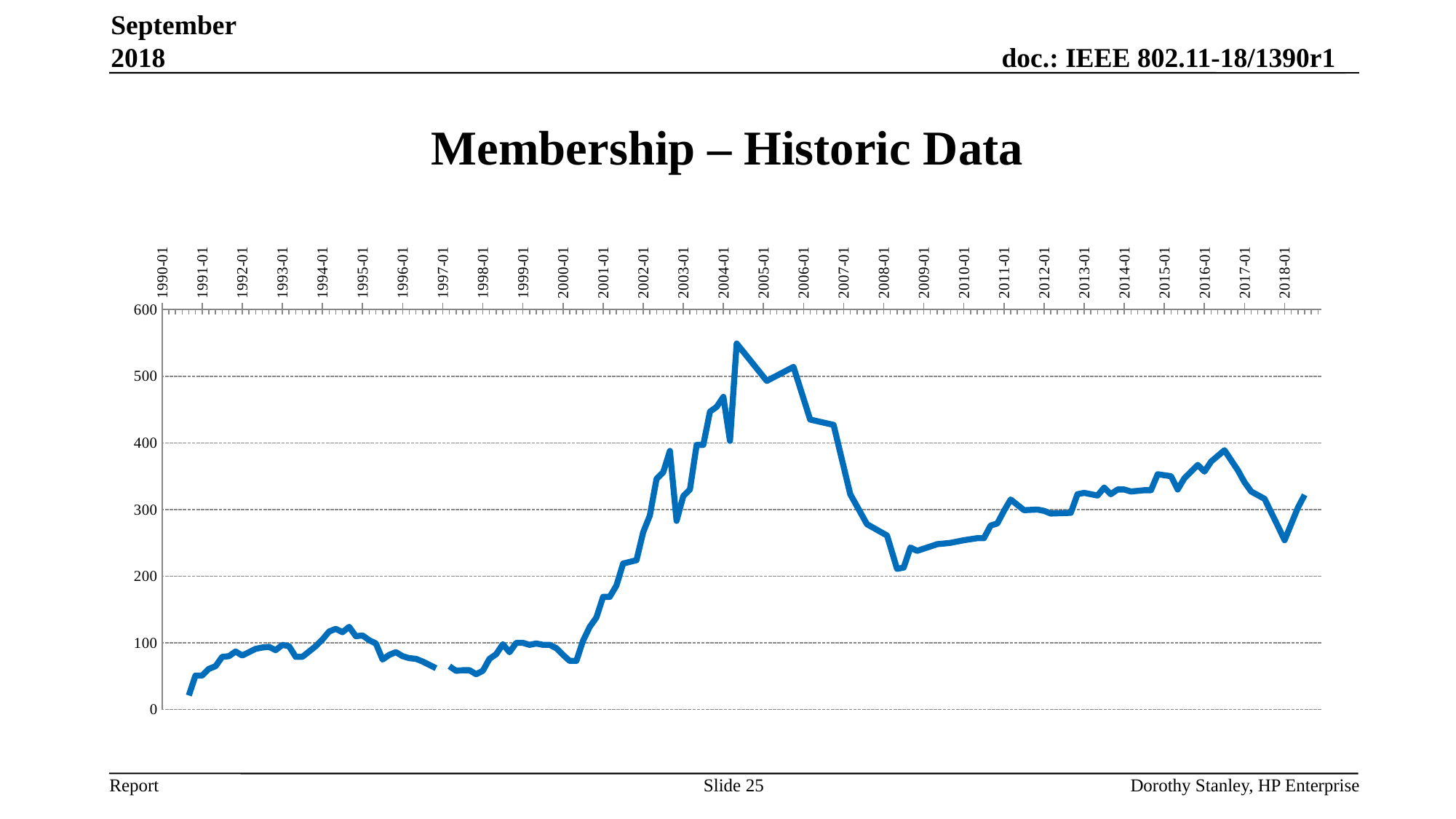
Is the membership value at 2016-01 greater or less than 300? greater Around which year does the membership line reach its lowest point? 1990 Around which year does the membership line reach its highest point? 2004 Is the membership value at 2001-01 greater or less than 200? less Does the membership line generally rise or fall between 2009-01 and 2016-01? rise What kind of chart is shown on the slide? line chart What is the highest value shown on the y axis of the chart? 600 Does the membership line generally rise or fall between 2005-01 and 2008-01? fall Is the membership value at 2008-01 greater or less than 300? less How many year labels are shown along the x axis of the chart? 29 What is the title of the chart? Membership – Historic Data